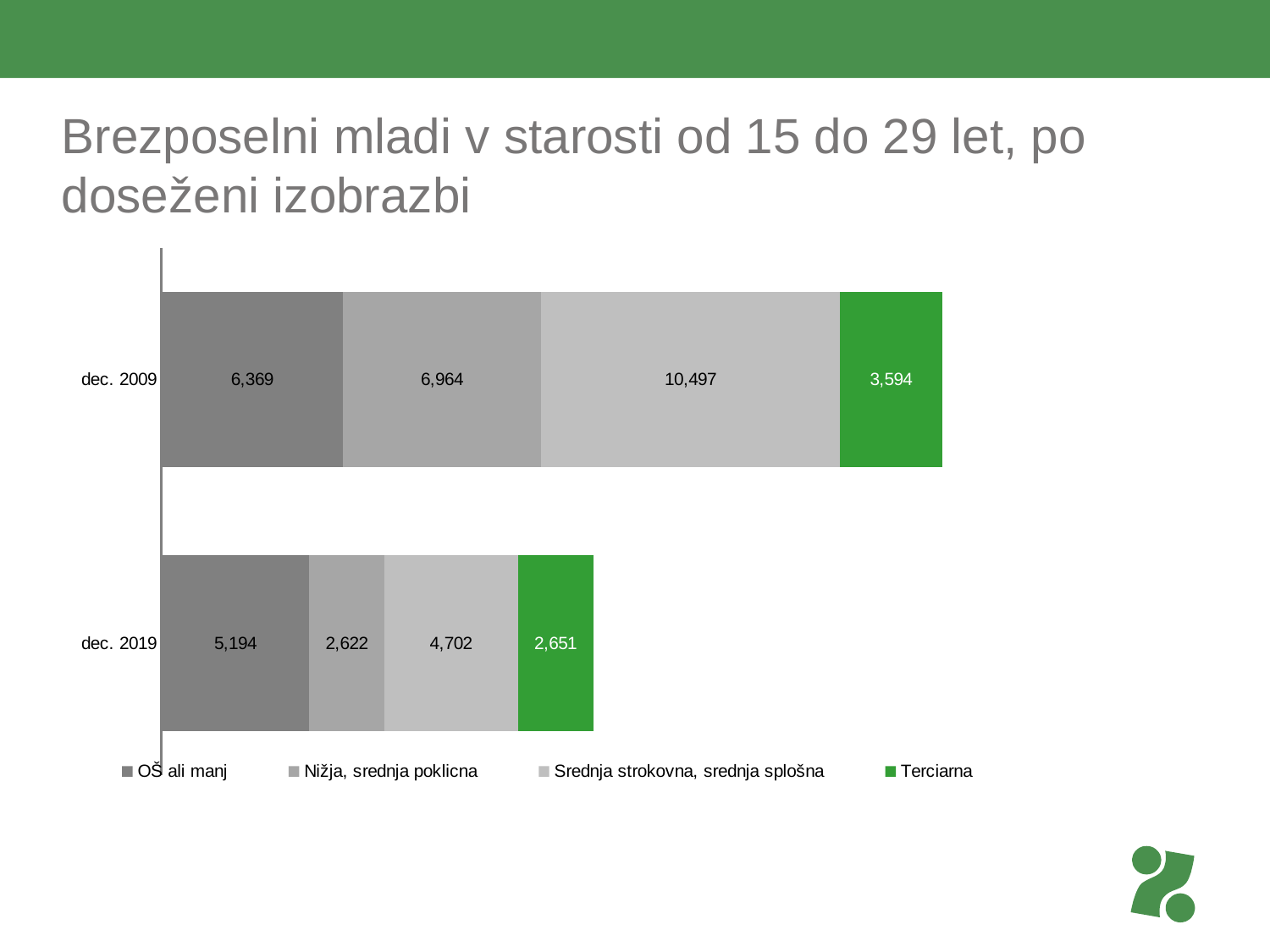
What is the total of the stacked bar for dec. 2019? 15,169 How many series does the legend list? 4 What is the value for Terciarna in dec. 2019? 2,651 What is the value for Srednja strokovna, srednja splošna in dec. 2009? 10,497 Which education group has the lowest value in dec. 2019? Nižja, srednja poklicna What kind of chart is shown on the slide? Stacked bar chart What is the value for OŠ ali manj in dec. 2019? 5,194 Which is larger: Terciarna in dec. 2009 or Terciarna in dec. 2019? Terciarna in dec. 2009 What is the total of the stacked bar for dec. 2009? 27,424 Which education group has the highest value in dec. 2009? Srednja strokovna, srednja splošna What is the difference between the Srednja strokovna, srednja splošna values for dec. 2009 and dec. 2019? 5,795 What is the value for Nižja, srednja poklicna in dec. 2009? 6,964